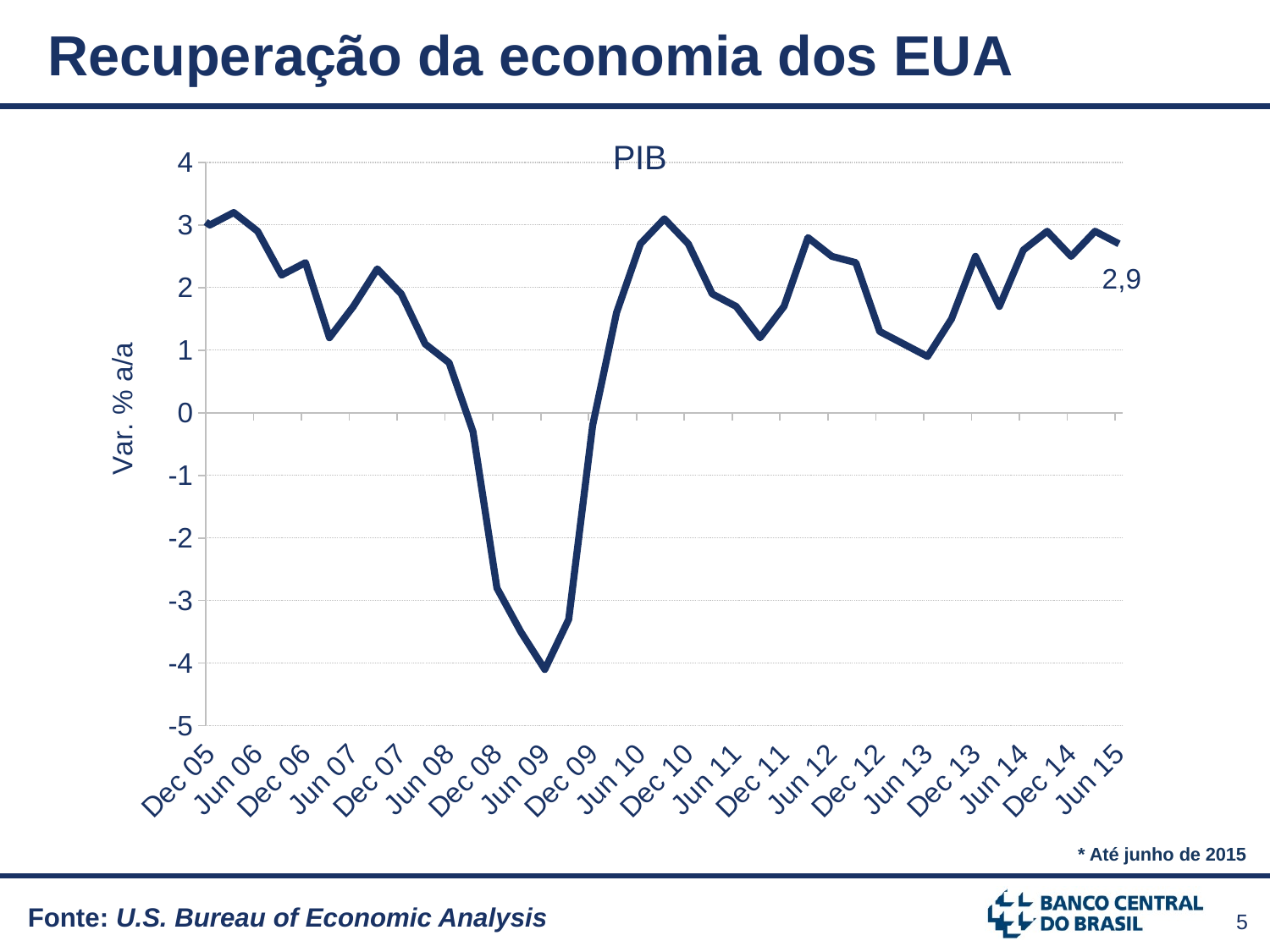
Is the value for Jun 13 greater or less than 2? less At which x-axis label does the PIB line reach its lowest point? Jun 09 What kind of chart is shown on the slide? line chart What is the label on the y axis of the chart? Var. % a/a What is the value of the PIB line at Jun 15? 2,9 Is the value for Dec 05 greater or less than 2? greater How many labels are shown on the x axis? 20 Is the value for Jun 09 greater or less than -3? less Does the PIB line rise or fall between Jun 09 and Jun 10? rise Which is larger, the value at Jun 10 or the value at Jun 13? Jun 10 Which is larger, the value at Dec 05 or the value at Jun 09? Dec 05